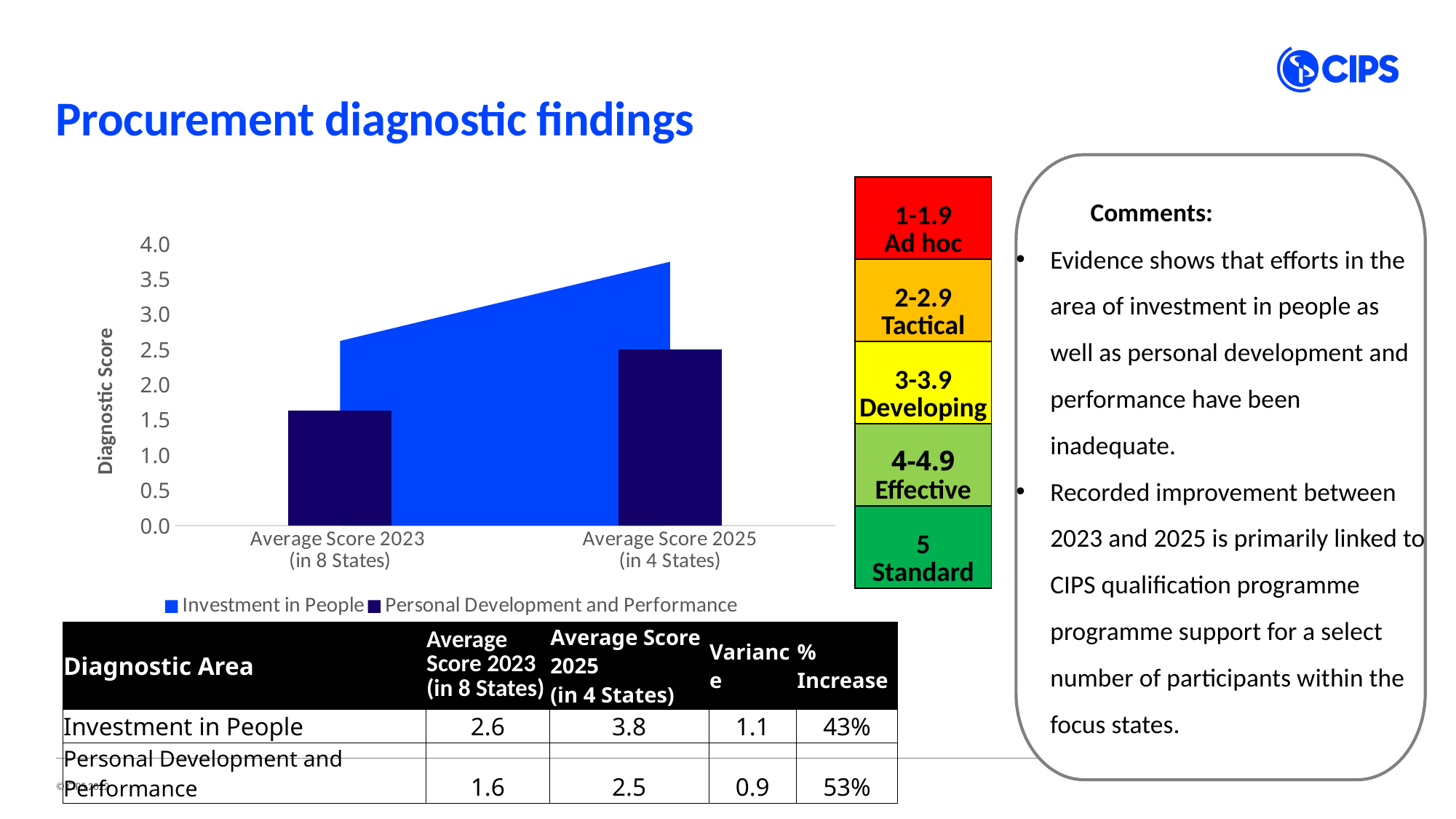
By how much did the Personal Development and Performance score increase from Average Score 2023 (in 8 States) to Average Score 2025 (in 4 States)? 0.9 What is the Average Score 2023 (in 8 States) for Investment in People? 2.6 Do the Personal Development and Performance values rise or fall from 2023 to 2025? rise What kind of chart is used to plot the Personal Development and Performance series? bar chart How many series does the chart legend list? 2 What is the label on the vertical axis of the chart? Diagnostic Score Which series has the higher value for Average Score 2023 (in 8 States): Investment in People or Personal Development and Performance? Investment in People What is the Average Score 2025 (in 4 States) for Investment in People? 3.8 Is the Investment in People value for Average Score 2025 (in 4 States) greater or less than 3.5? greater Is the Personal Development and Performance value for Average Score 2023 (in 8 States) greater or less than 2.0? less What is the Average Score 2025 (in 4 States) for Personal Development and Performance? 2.5 How many categories are shown on the x axis of the chart? 2